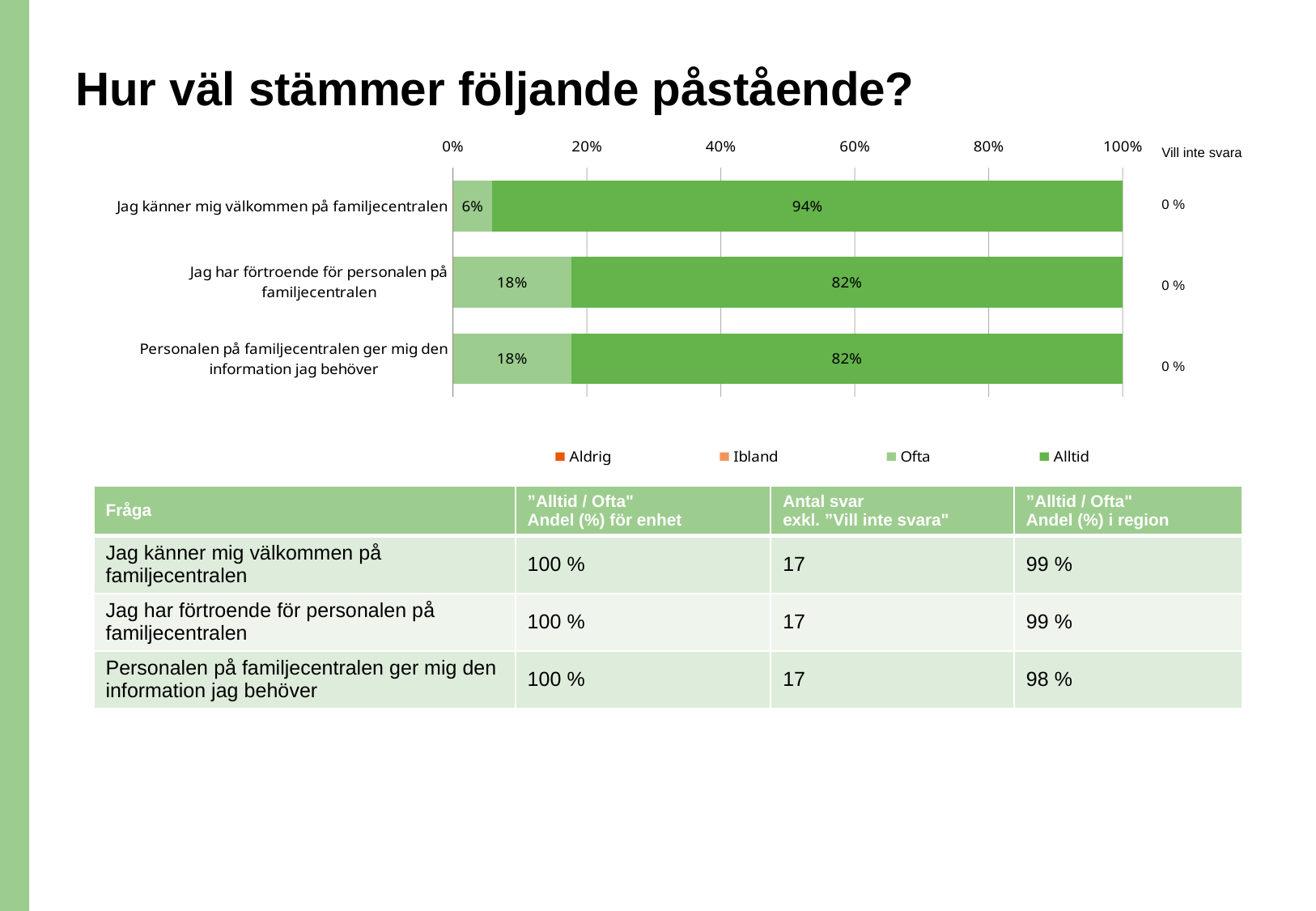
Which statement has the highest "Alltid" value? Jag känner mig välkommen på familjecentralen What is the "Vill inte svara" value shown for "Personalen på familjecentralen ger mig den information jag behöver"? 0 % Is the "Alltid" value for "Jag har förtroende för personalen på familjecentralen" larger or smaller than the "Alltid" value for "Jag känner mig välkommen på familjecentralen"? smaller What is the "Ofta" value for "Jag känner mig välkommen på familjecentralen"? 6% What is the "Alltid" value for "Jag känner mig välkommen på familjecentralen"? 94% How many series does the legend list? 4 What is the "Alltid" value for "Personalen på familjecentralen ger mig den information jag behöver"? 82% What is the "Ofta" value for "Jag har förtroende för personalen på familjecentralen"? 18% How many statements (categories) are shown in the chart? 3 Which statement has the lowest "Ofta" value? Jag känner mig välkommen på familjecentralen What is the difference between the "Alltid" values for "Jag känner mig välkommen på familjecentralen" and "Jag har förtroende för personalen på familjecentralen"? 12% What kind of chart is shown on the slide? stacked bar chart